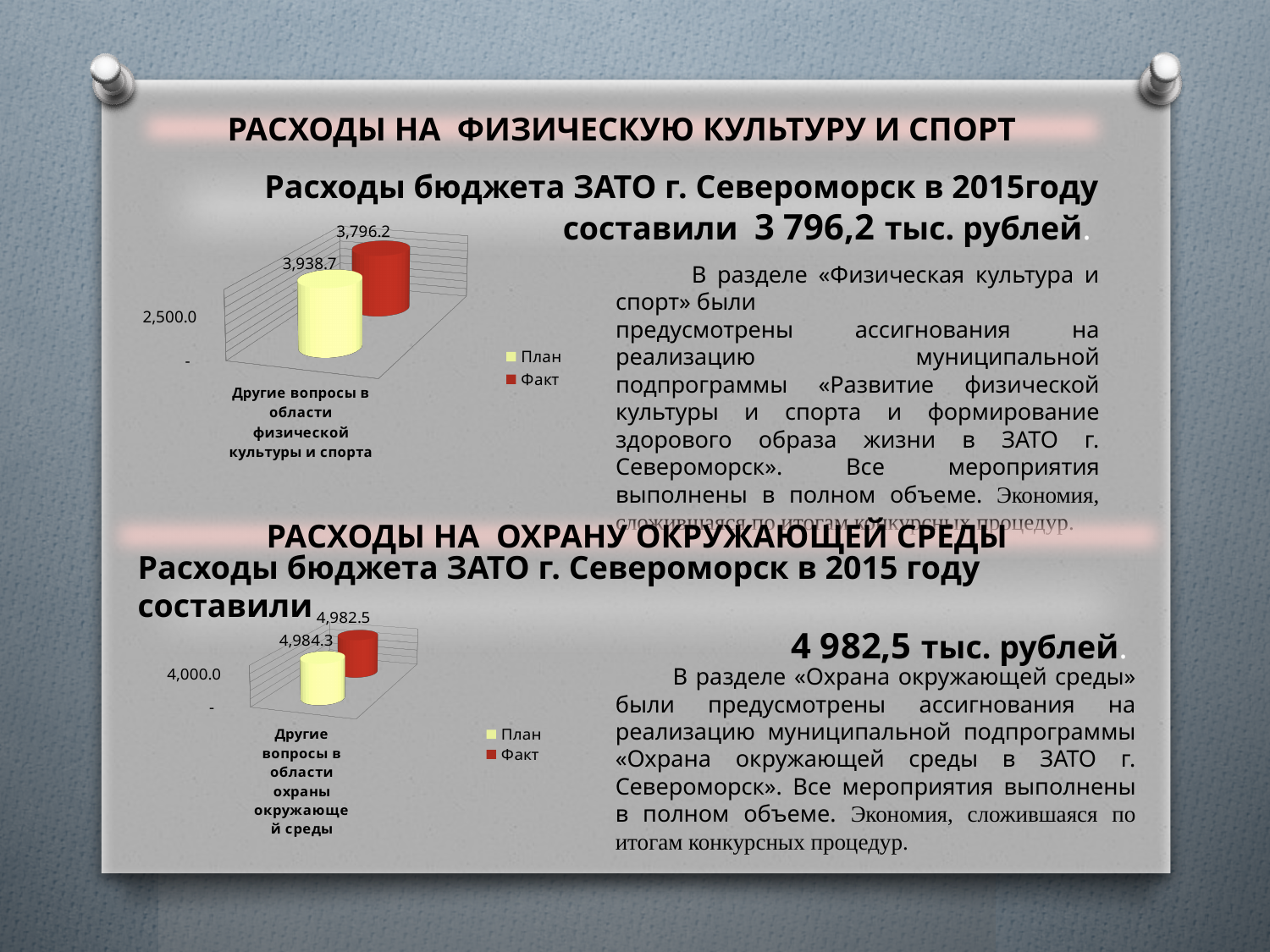
In the bottom chart, what is the value for План? 4,984.3 In the bottom chart, what is the value for Факт? 4,982.5 In the top chart, what is the difference between План and Факт? 142.5 What kind of chart is the top chart? Bar chart In the top chart, is the value for Факт greater or less than 2,500.0? greater In the bottom chart, what is the difference between План and Факт? 1.8 How many categories are shown on the x axis of the bottom chart? 1 In the bottom chart, which colour represents Факт? Red In the top chart, what is the value for План? 3,938.7 How many series does the legend of the top chart list? 2 In the top chart, what is the value for Факт? 3,796.2 In the top chart, which is larger, План or Факт? План